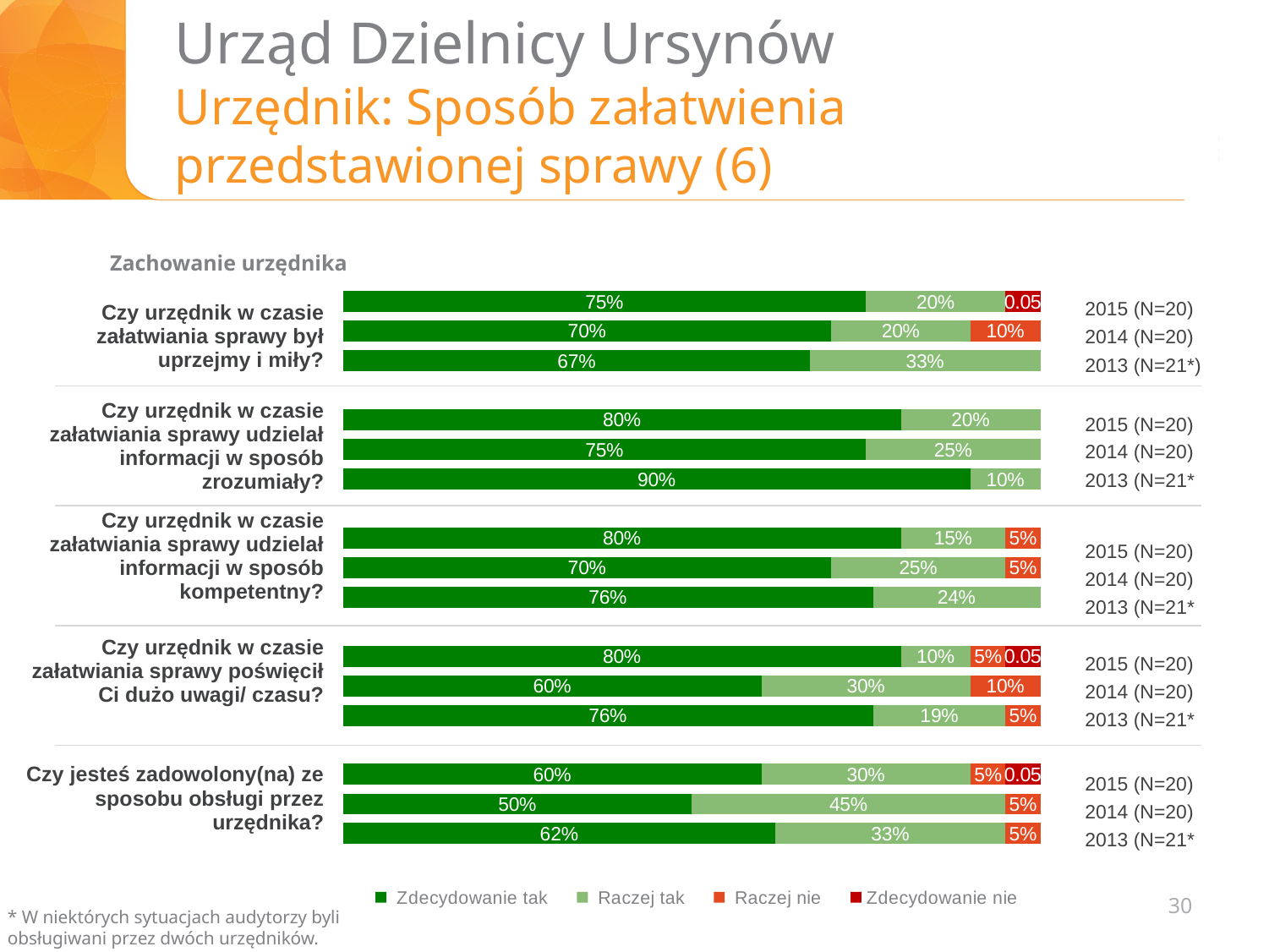
For the question 'Czy jesteś zadowolony(na) ze sposobu obsługi przez urzędnika?', which year has the lowest 'Zdecydowanie tak' value? 2014 What is the 'Raczej tak' value for 2014 for the question 'Czy jesteś zadowolony(na) ze sposobu obsługi przez urzędnika?' 45% How many series does the legend list? 4 What is the 'Zdecydowanie tak' value for 2015 for the question 'Czy urzędnik w czasie załatwiania sprawy był uprzejmy i miły?' 75% What is the sample size (N) shown for 2013? N=21* For the question 'Czy urzędnik w czasie załatwiania sprawy poświęcił Ci dużo uwagi/ czasu?', what is the difference between the 'Zdecydowanie tak' values for 2015 and 2014? 20% How many survey questions are shown in the chart? 5 For the question 'Czy urzędnik w czasie załatwiania sprawy udzielał informacji w sposób kompetentny?', which year has the highest 'Zdecydowanie tak' value? 2015 What is the 'Raczej nie' value for 2014 for the question 'Czy urzędnik w czasie załatwiania sprawy poświęcił Ci dużo uwagi/ czasu?' 10% What kind of chart is shown on the slide? stacked bar chart For the question 'Czy urzędnik w czasie załatwiania sprawy udzielał informacji w sposób zrozumiały?', is the 'Zdecydowanie tak' value larger in 2015 or in 2014? 2015 What is the 'Zdecydowanie tak' value for 2013 for the question 'Czy urzędnik w czasie załatwiania sprawy udzielał informacji w sposób zrozumiały?' 90%